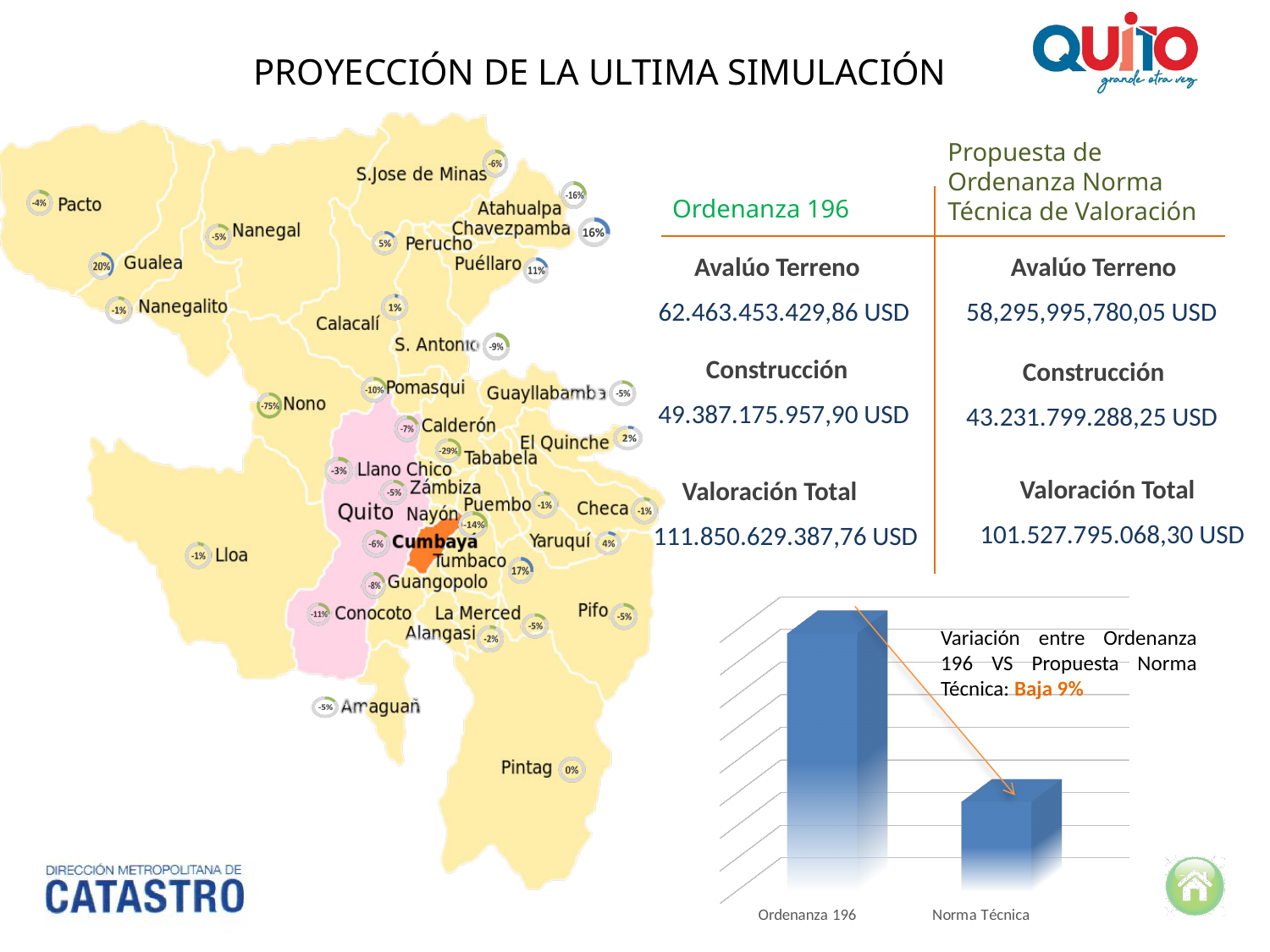
What are the two category labels on the x axis of the bar chart at the bottom right? Ordenanza 196 and Norma Técnica According to the annotation next to the bar chart, what is the variation between Ordenanza 196 and the Propuesta Norma Técnica? Baja 9% In the bar chart at the bottom right, which category has the tallest bar? Ordenanza 196 In the bar chart at the bottom right, do the bars rise or fall from left to right? fall How many bars does the bar chart at the bottom right of the slide show? 2 What kind of chart is shown at the bottom right of the slide? bar chart In the bar chart at the bottom right, is the bar for Ordenanza 196 taller or shorter than the bar for Norma Técnica? taller In the bar chart at the bottom right, which category has the shortest bar? Norma Técnica